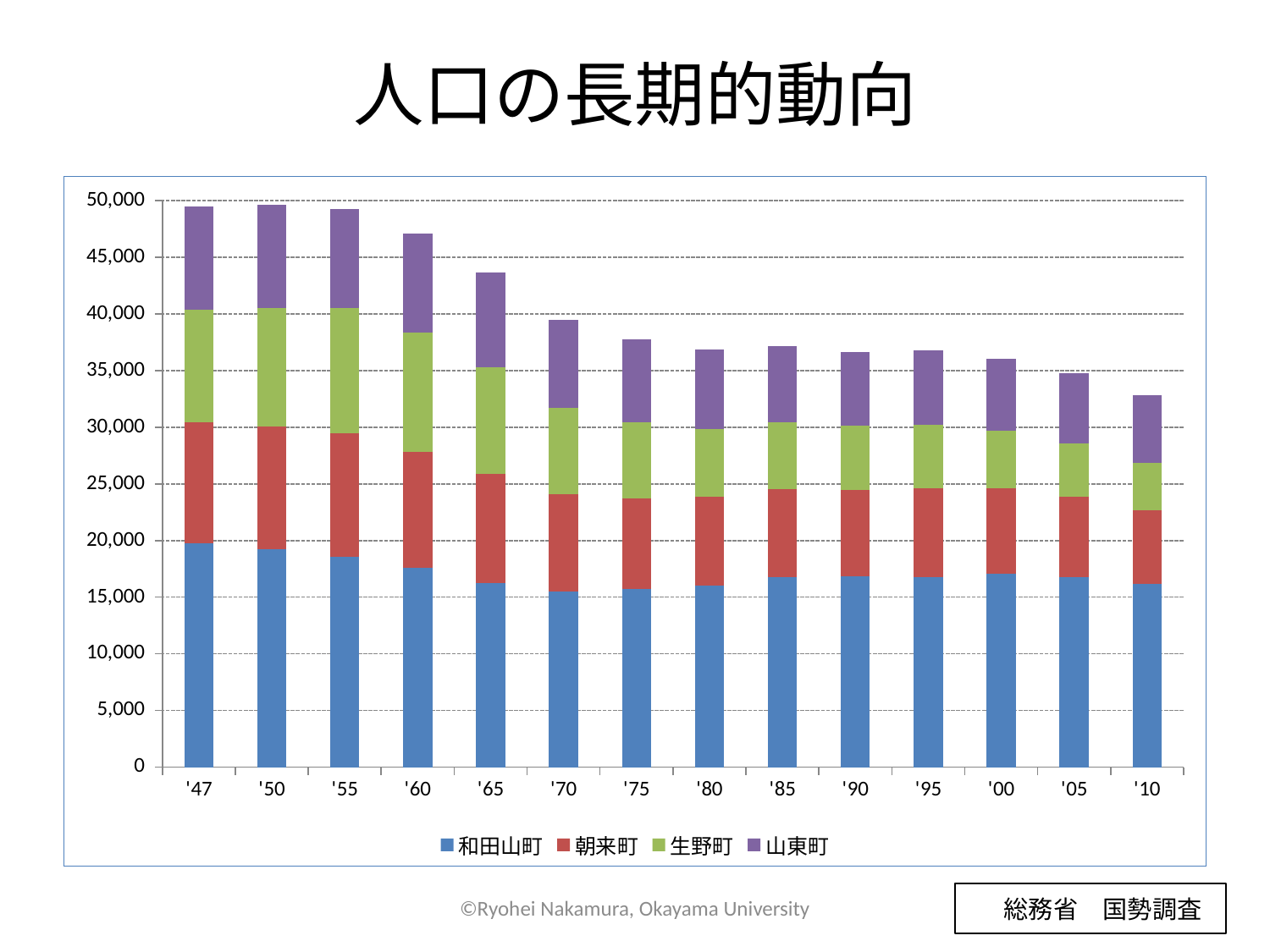
Which series is shown in blue in the legend? 和田山町 Is the total stacked value for '10 greater or less than 35,000? less Is the total stacked value for '65 greater or less than 45,000? less What is the title of the chart? 人口の長期的動向 Do the total stacked values generally rise or fall from '47 to '10? fall How many series does the legend list? 4 Which has the larger total stacked value, '60 or '65? '60 Is the total stacked value for '47 greater or less than 45,000? greater What kind of chart is shown on the slide? stacked bar chart How many years (categories) are shown on the x axis? 14 Which year has the lowest total stacked bar? '10